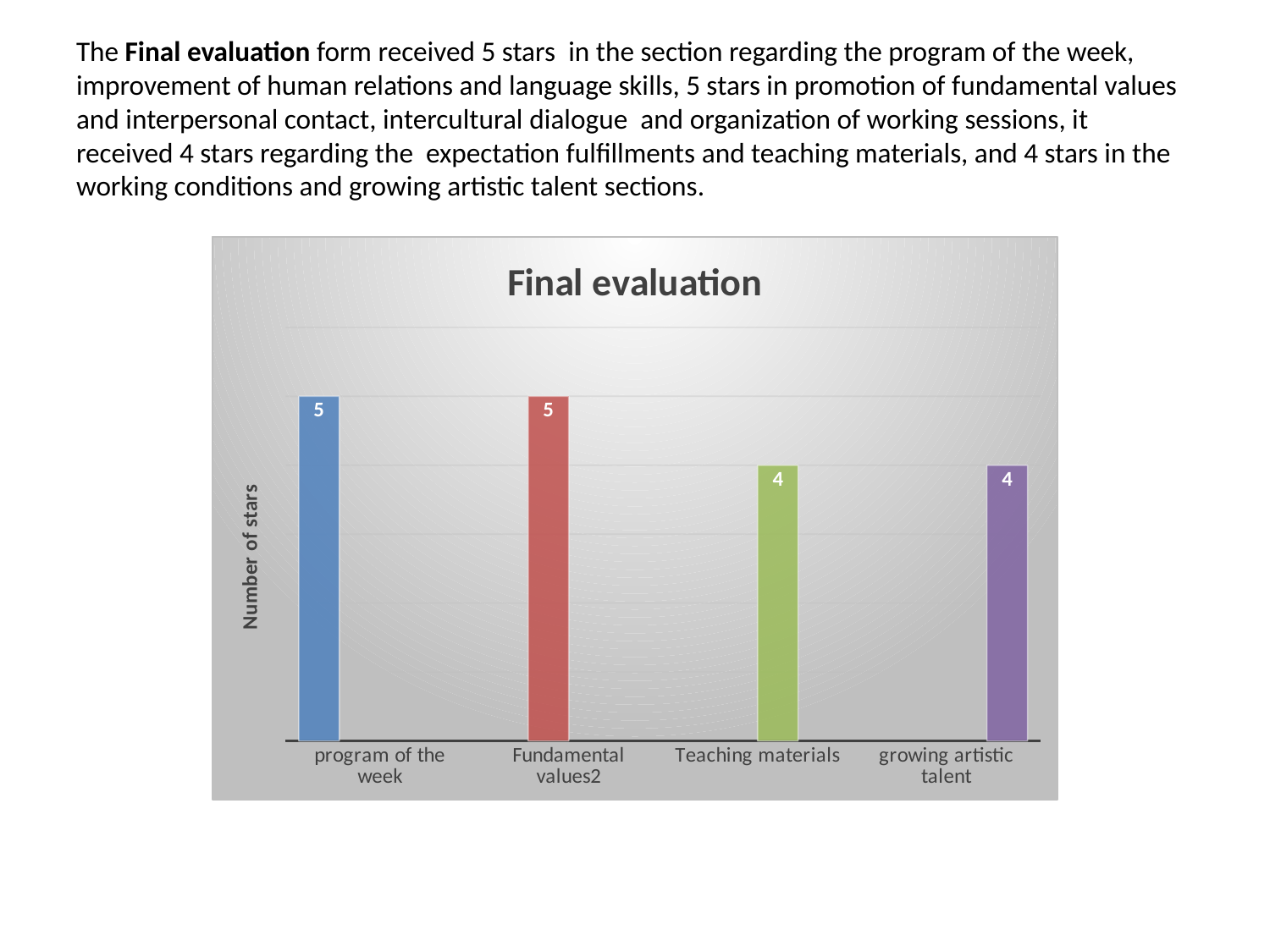
How many stars does the chart show for program of the week? 5 Which categories have the lowest value in the chart? Teaching materials and growing artistic talent How many categories are shown on the x axis of the chart? 4 What is the title of the chart? Final evaluation Do the values rise or fall from program of the week to growing artistic talent? fall What is the label of the vertical axis? Number of stars How many stars are shown for Teaching materials? 4 What is the difference between the values for program of the week and Teaching materials? 1 What kind of chart is shown on the slide? bar chart Which is larger, the value for Fundamental values2 or the value for growing artistic talent? Fundamental values2 What is the value for growing artistic talent? 4 What is the value for Fundamental values2 in the Final evaluation chart? 5